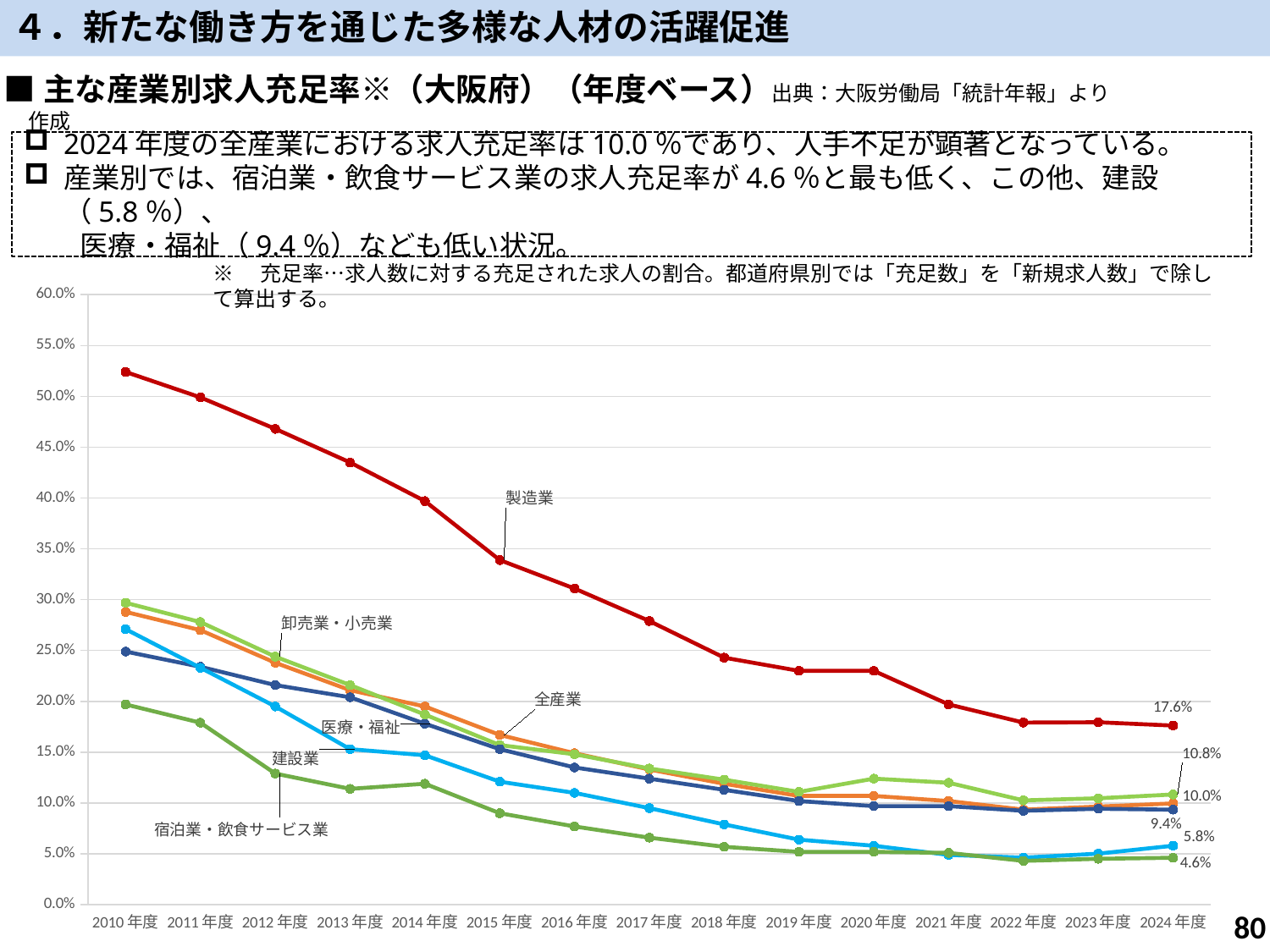
What is the value for 建設業 in 2024年度? 5.8% Is the value for 製造業 in 2010年度 greater or less than 50.0%? greater Does the 製造業 line rise or fall from 2010年度 to 2024年度? fall How many fiscal years are plotted along the x axis? 15 What is the value for 宿泊業・飲食サービス業 in 2024年度? 4.6% What is the difference between 製造業 and 全産業 in 2024年度? 7.6% What is the value for 製造業 in 2024年度? 17.6% How many industry series are labelled on the chart? 6 What kind of chart is shown on the slide? line chart What is the value for 全産業 in 2024年度? 10.0% Which industry has the highest value in 2024年度? 製造業 Which industry has the lowest value in 2024年度? 宿泊業・飲食サービス業